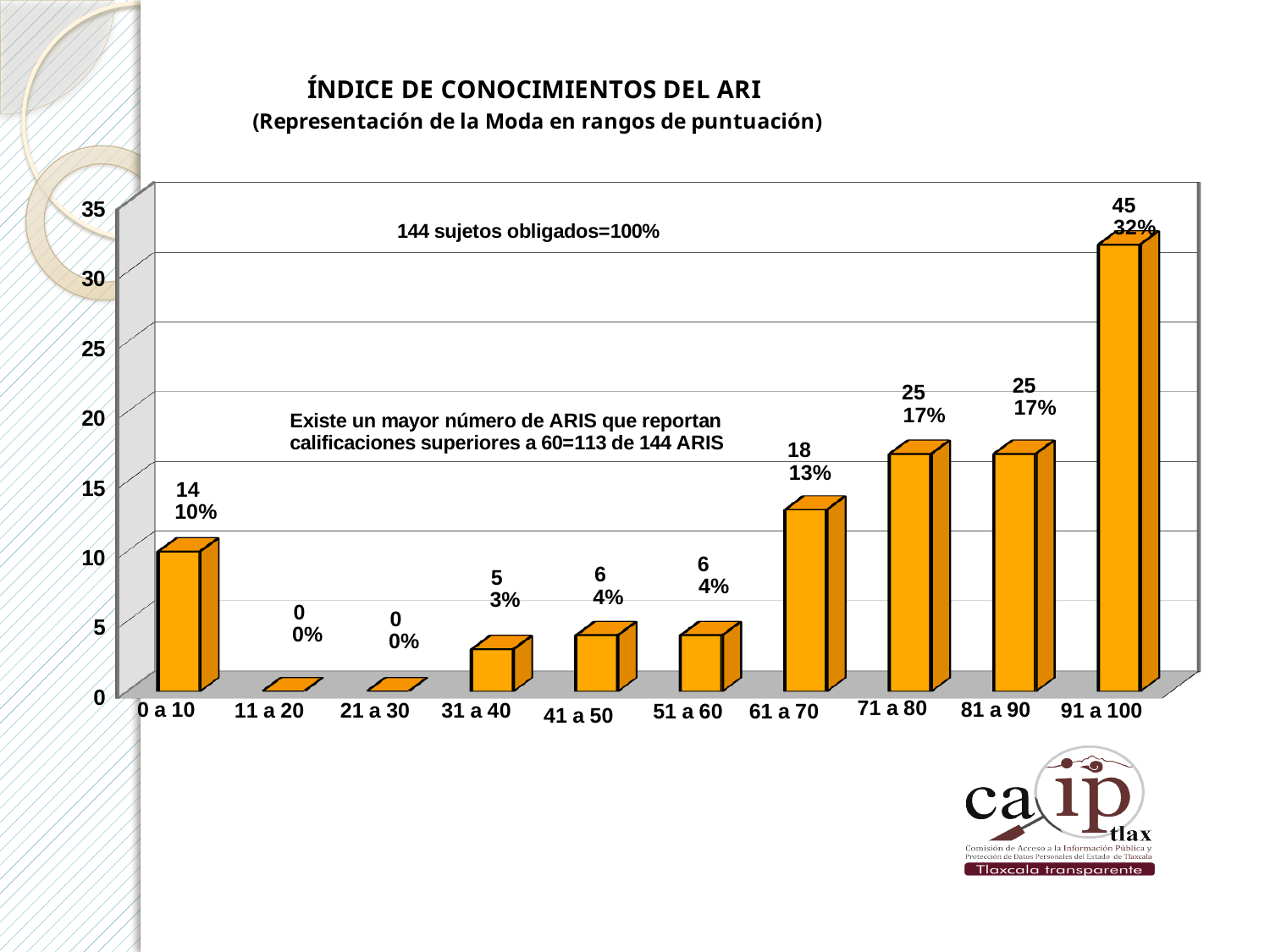
What is the difference between the values for '91 a 100' and '81 a 90'? 20 What is the title of the chart? ÍNDICE DE CONOCIMIENTOS DEL ARI How many score ranges are shown on the x axis? 10 What is the value for the '91 a 100' range? 45 What kind of chart is shown on the slide? Bar chart What is the value for the '0 a 10' range? 14 How many score ranges have a value of 0? 2 Which is larger, the value for '0 a 10' or the value for '31 a 40'? 0 a 10 What percentage is shown for the '61 a 70' range? 13% What is the value for the '41 a 50' range? 6 Which score range has the highest value? 91 a 100 What is the total of the values for '71 a 80' and '81 a 90'? 50